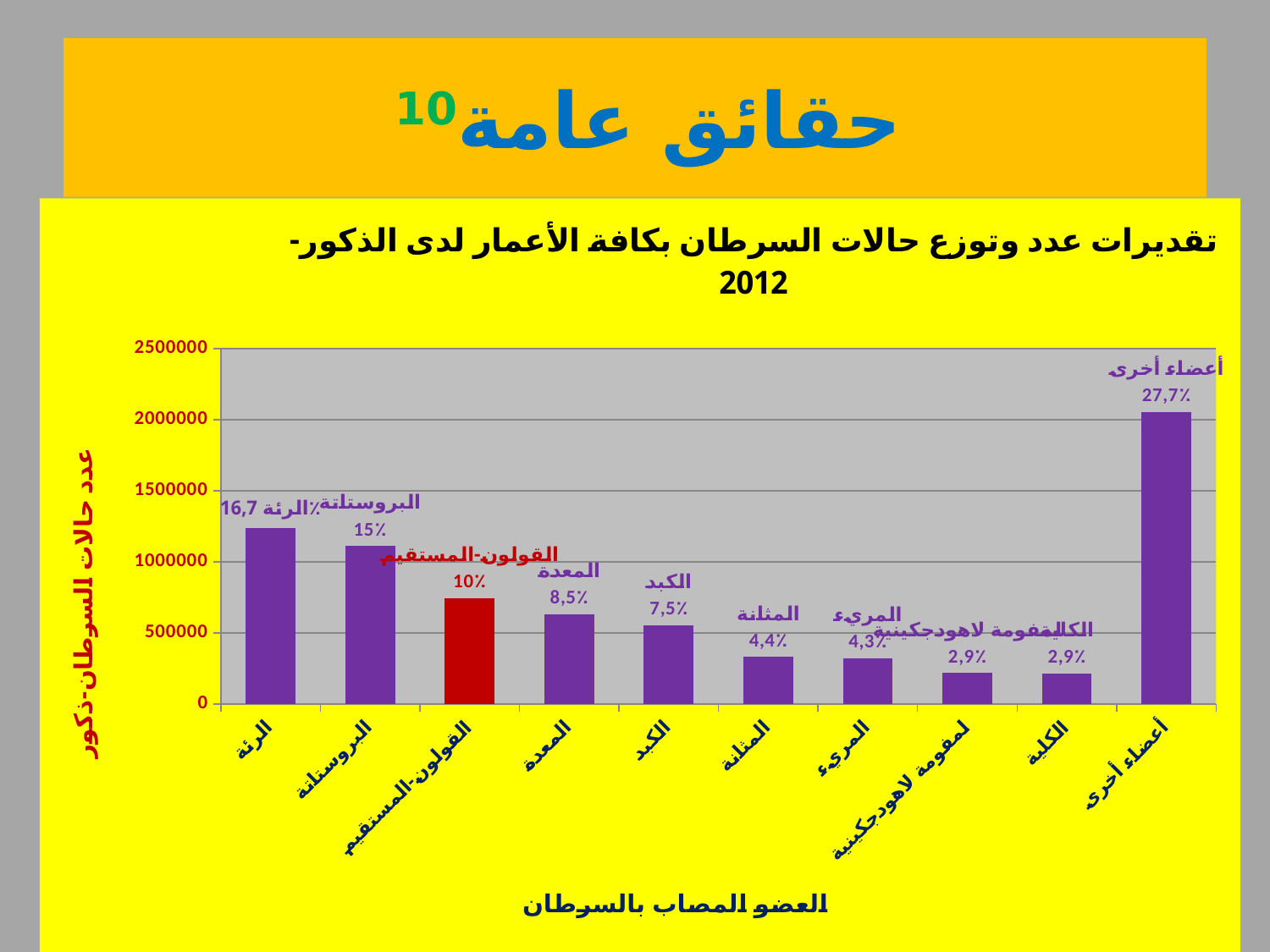
What type of chart is shown on the slide? bar chart Is the number of cases for الرئة greater or less than 1000000? greater What is the difference in percentage points between الرئة and البروستاتة? 1,7% What percentage is labelled on the bar for البروستاتة? 15% Is the number of cases for الكلية greater or less than 500000? less Which category's bar is coloured red instead of purple? القولون-المستقيم What percentage is labelled on the bar for الرئة? 16,7% What percentage is labelled on the bar for القولون-المستقيم? 10% Which category has the highest bar? أعضاء أخرى How many organ categories are plotted on the x axis? 10 What percentage is labelled on the bar for أعضاء أخرى? 27,7% Which has the larger value, المعدة or الكبد? المعدة